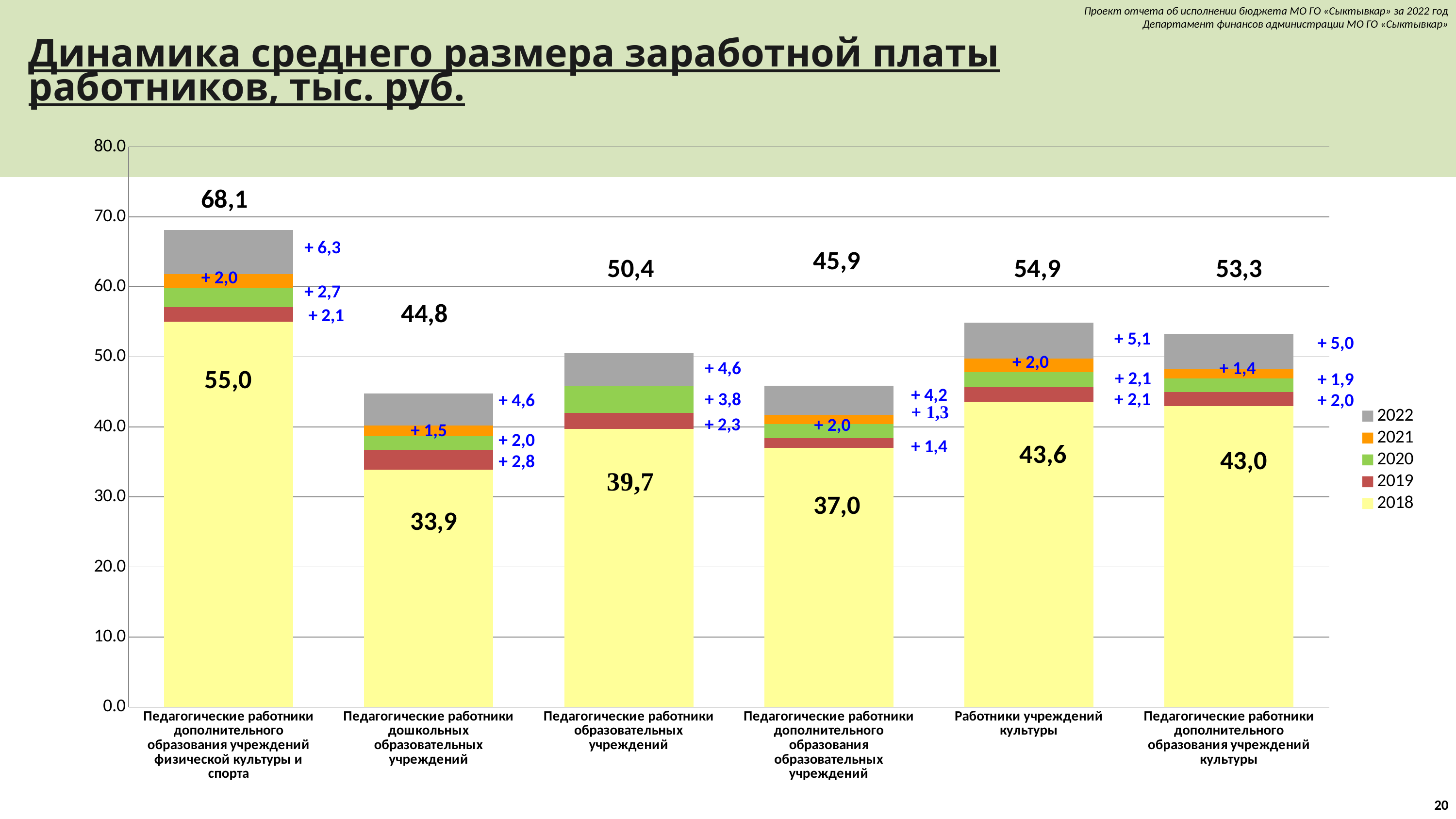
How many series does the legend list? 5 Which year does the grey colour represent in the legend? 2022 Which category has the highest total value? Педагогические работники дополнительного образования учреждений физической культуры и спорта What is the difference between the total for «Работники учреждений культуры» (54,9) and the total for «Педагогические работники дополнительного образования учреждений культуры» (53,3)? 1,6 What kind of chart is shown on the slide? Stacked bar chart What is the 2018 value for «Работники учреждений культуры»? 43,6 What is the 2022 increment shown for «Педагогические работники дополнительного образования учреждений физической культуры и спорта»? + 6,3 Which category has the lowest total value? Педагогические работники дошкольных образовательных учреждений Which is larger: the total for «Педагогические работники образовательных учреждений» or the total for «Педагогические работники дополнительного образования образовательных учреждений»? Педагогические работники образовательных учреждений What is the 2018 value for «Педагогические работники дополнительного образования образовательных учреждений»? 37,0 How many categories of workers are shown on the x axis? 6 What is the total value shown above the bar for «Педагогические работники дошкольных образовательных учреждений»? 44,8